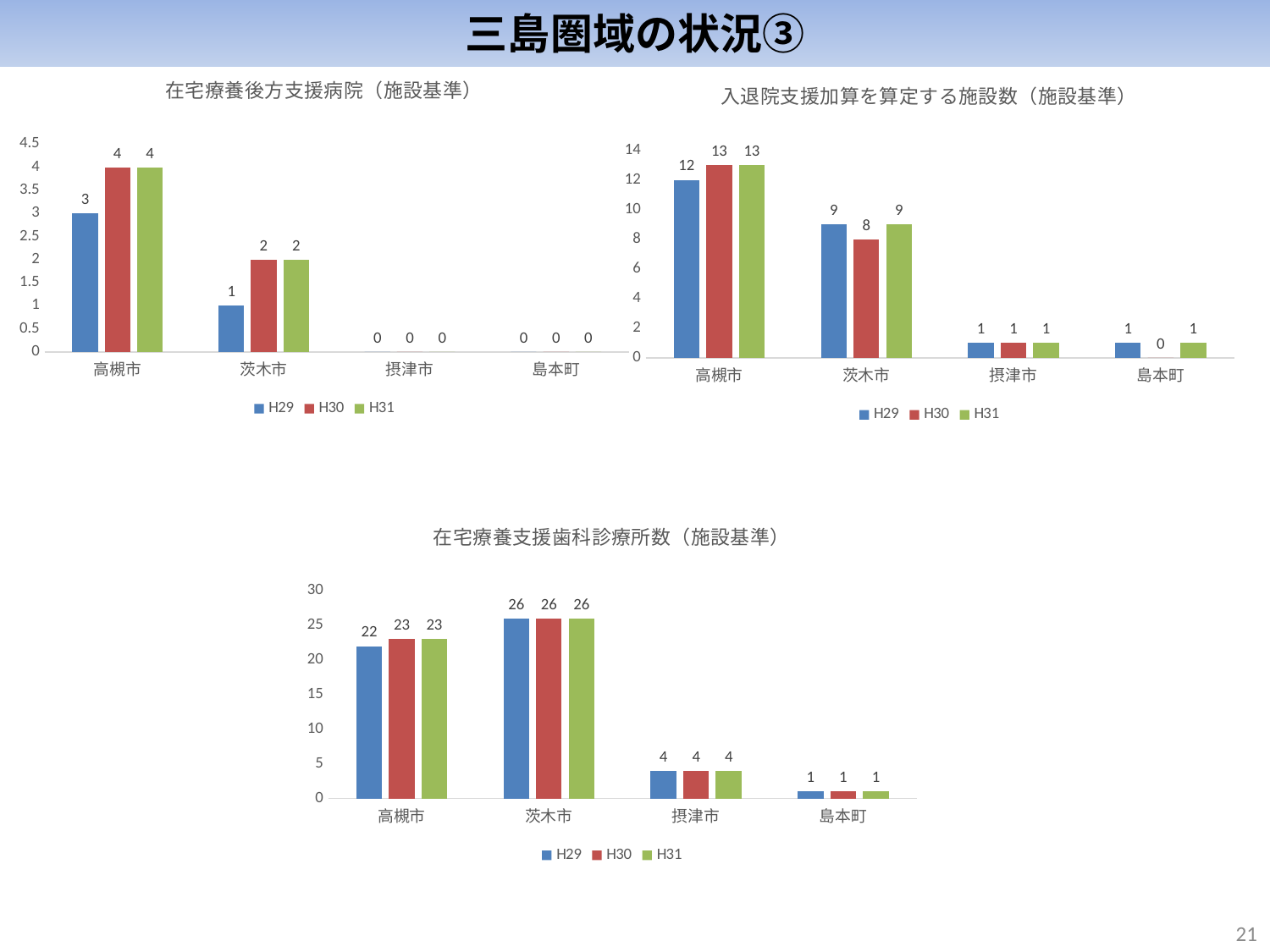
In the chart titled 入退院支援加算を算定する施設数（施設基準）, what is the H30 value for 茨木市? 8 In the chart titled 在宅療養支援歯科診療所数（施設基準）, which is larger, the H31 value for 茨木市 or the H31 value for 高槻市? 茨木市 In the chart titled 在宅療養後方支援病院（施設基準）, what is the H31 value for 茨木市? 2 In the chart titled 入退院支援加算を算定する施設数（施設基準）, how many series does the legend list? 3 In the chart titled 在宅療養支援歯科診療所数（施設基準）, which category has the lowest H30 value? 島本町 What kind of chart is the chart titled 在宅療養支援歯科診療所数（施設基準）? bar chart In the chart titled 在宅療養後方支援病院（施設基準）, how many categories are shown on the x axis? 4 In the chart titled 入退院支援加算を算定する施設数（施設基準）, what is the difference between the H31 values for 高槻市 and 茨木市? 4 In the chart titled 在宅療養支援歯科診療所数（施設基準）, what is the H29 value for 高槻市? 22 In the chart titled 在宅療養後方支援病院（施設基準）, what is the H29 value for 高槻市? 3 In the chart titled 入退院支援加算を算定する施設数（施設基準）, what is the H30 value for 島本町? 0 In the chart titled 入退院支援加算を算定する施設数（施設基準）, which category has the highest H31 value? 高槻市